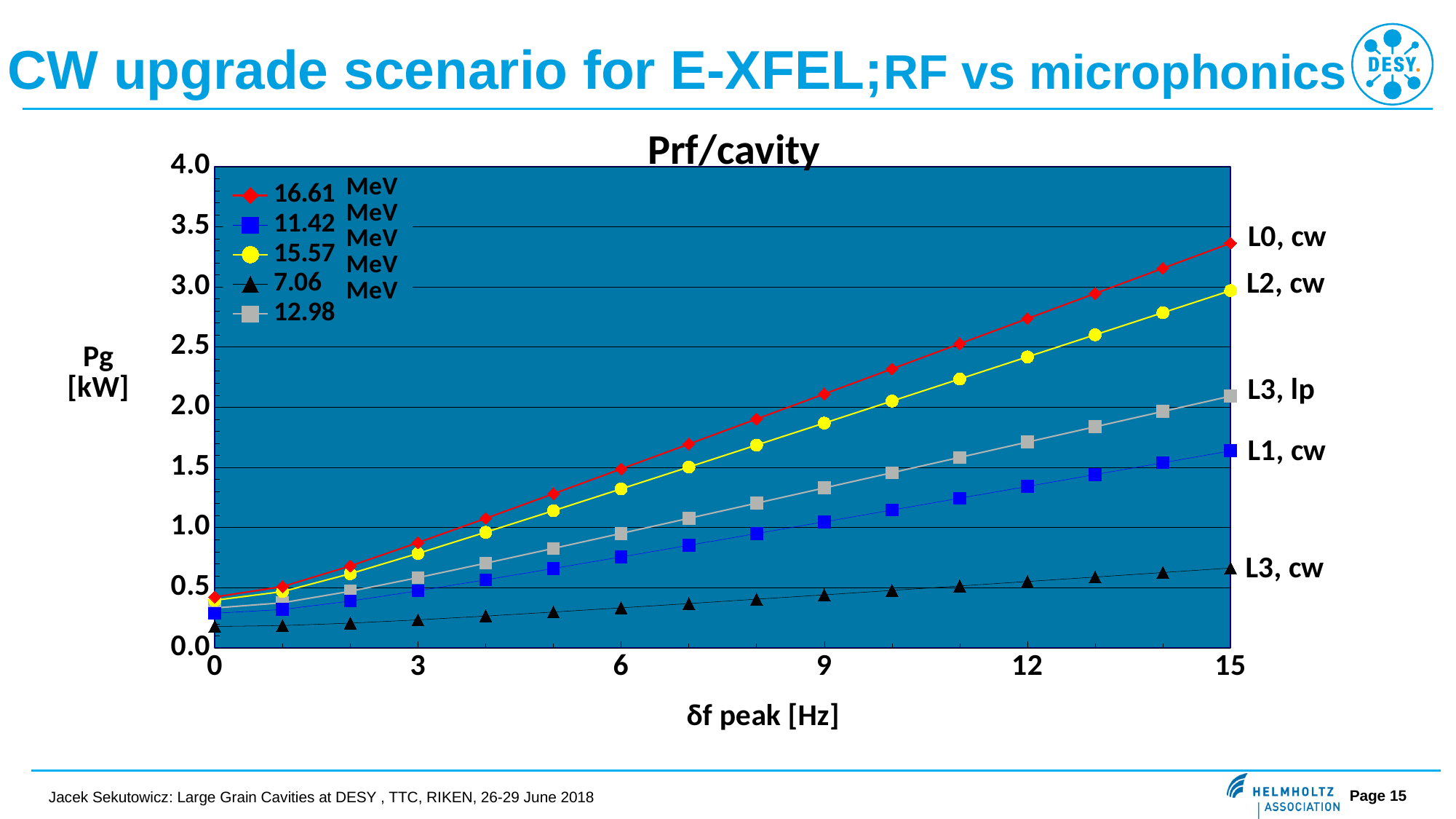
What is the title of the chart? Prf/cavity What is the label of the x axis? δf peak [Hz] Which series has the highest Pg value at δf peak = 15 Hz? 16.61 MeV Is the value for the 16.61 MeV series at δf peak = 12 Hz greater or less than 2.5 kW? greater Is the value for the 7.06 MeV series at δf peak = 15 Hz greater or less than 1.0 kW? less How many series does the legend list? 5 At δf peak = 15 Hz, which series has the larger Pg value: 12.98 MeV or 11.42 MeV? 12.98 MeV What kind of chart is shown on the slide? line chart Do the Pg values for the 16.61 MeV series rise or fall as δf peak increases? rise Is the value for the 16.61 MeV series at δf peak = 15 Hz greater or less than 3.0 kW? greater Which series has the lowest Pg value at δf peak = 15 Hz? 7.06 MeV